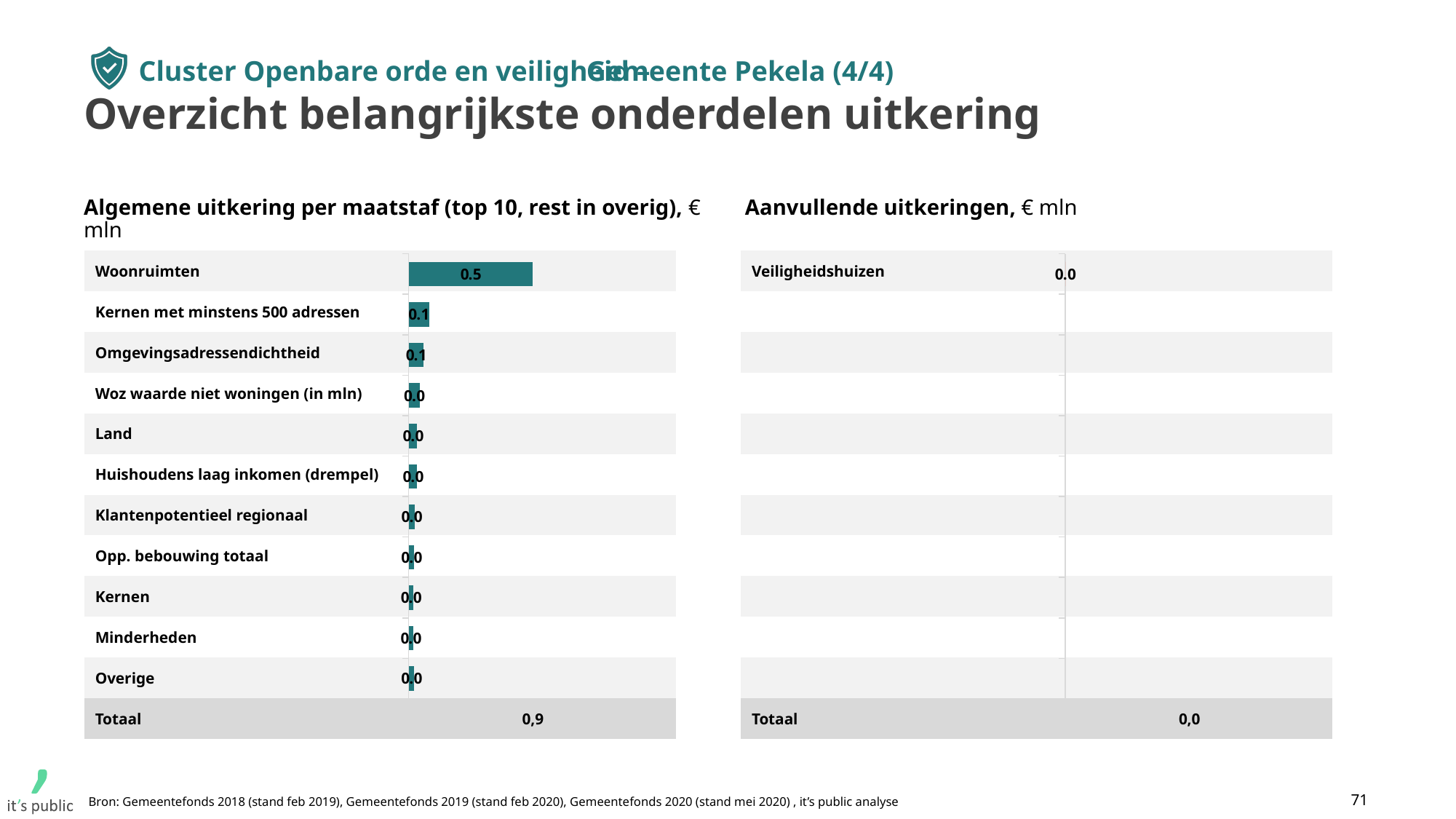
In the chart 'Algemene uitkering per maatstaf', which category has the highest value? Woonruimten In the chart 'Algemene uitkering per maatstaf', how many categories are listed (excluding the Totaal row)? 11 In the chart 'Algemene uitkering per maatstaf', what is the difference between Woonruimten and Kernen met minstens 500 adressen? 0.4 In the chart 'Aanvullende uitkeringen', what is the value shown in the Totaal row? 0,0 What kind of chart is the 'Algemene uitkering per maatstaf' chart? Bar chart In the chart 'Algemene uitkering per maatstaf', what is the value for Woonruimten? 0.5 In the chart 'Algemene uitkering per maatstaf', which is larger: Woonruimten or Kernen met minstens 500 adressen? Woonruimten In the chart 'Algemene uitkering per maatstaf', what is the value for Kernen met minstens 500 adressen? 0.1 In the chart 'Algemene uitkering per maatstaf', what is the value for Omgevingsadressendichtheid? 0.1 In the chart 'Algemene uitkering per maatstaf', what is the value shown in the Totaal row? 0,9 In the chart 'Aanvullende uitkeringen', what is the value for Veiligheidshuizen? 0.0 In the chart 'Aanvullende uitkeringen', how many categories are listed (excluding the Totaal row)? 1